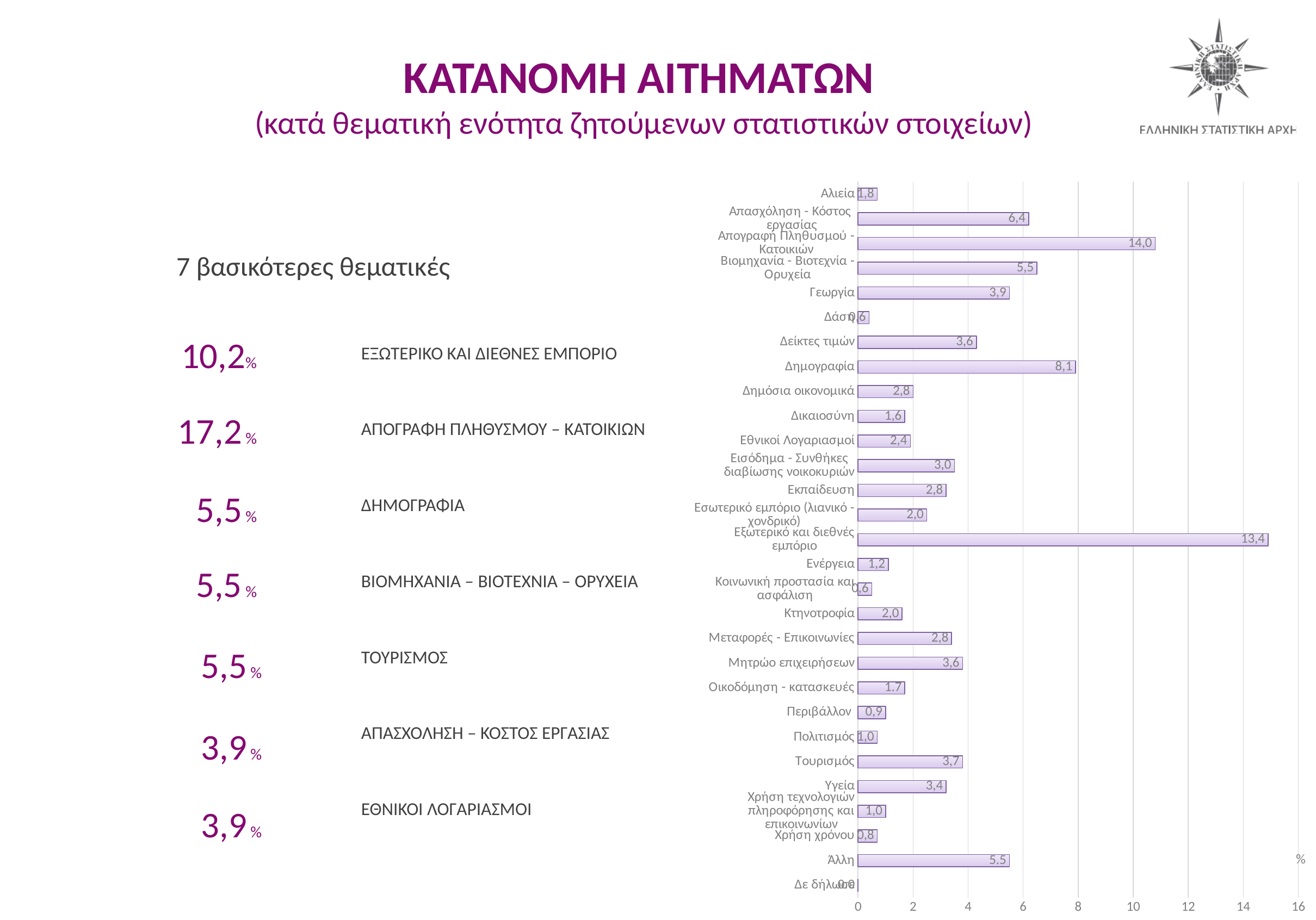
What is the value for Δημογραφία in the chart? 8,1 What is the value for Απασχόληση - Κόστος εργασίας in the chart? 6,4 What is the difference between the values for Άλλη and Γεωργία? 1,6 What is the value for Εθνικοί Λογαριασμοί in the chart? 2,4 What is the highest tick value shown on the horizontal axis of the chart? 16 Which category has the lowest value in the chart? Δε δήλωσε What is the value for Υγεία in the chart? 3,4 What is the value for Τουρισμός in the chart? 3,7 What kind of chart is shown on the slide? bar chart What is the difference between the values for Δημογραφία and Απασχόληση - Κόστος εργασίας? 1,7 How many categories are plotted in the chart? 29 Which is larger, the value for Δημογραφία or the value for Απασχόληση - Κόστος εργασίας? Δημογραφία